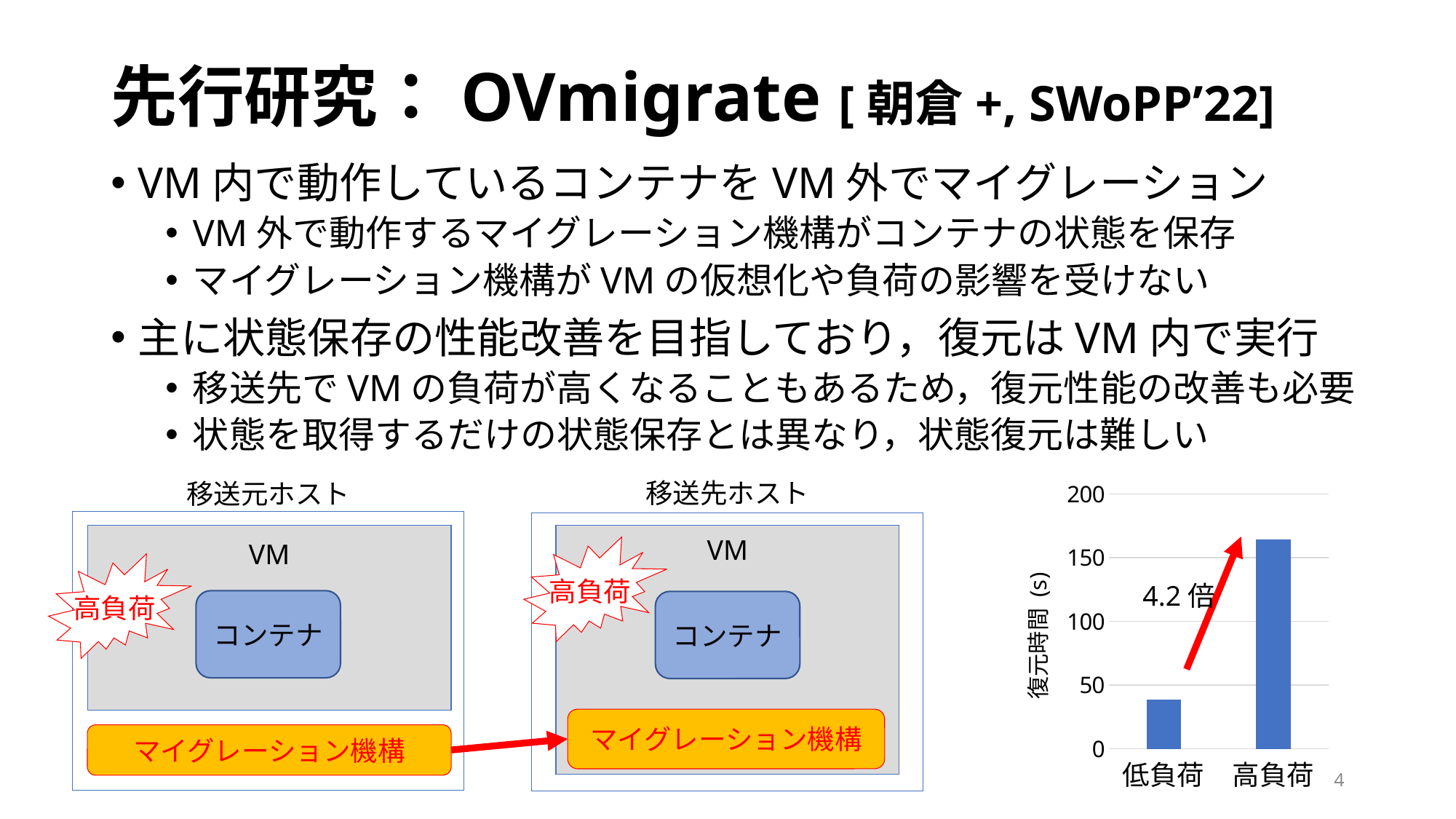
What is the highest tick value shown on the y axis of the bar chart? 200 In the bar chart, is the value for 高負荷 greater or less than 200? less Which category has the higher 復元時間 in the bar chart? 高負荷 What ratio is annotated next to the red arrow in the bar chart? 4.2 倍 In the bar chart, is the value for 高負荷 greater or less than 150? greater What is the label of the y axis of the bar chart? 復元時間 (s) What kind of chart is shown at the bottom right of the slide? bar chart In the bar chart, is the value for 低負荷 greater or less than 50? less Which category has the lower 復元時間 in the bar chart? 低負荷 Which is larger in the bar chart: the value for 低負荷 or the value for 高負荷? 高負荷 Do the values in the bar chart rise or fall from 低負荷 to 高負荷? rise How many categories are plotted on the x axis of the bar chart? 2